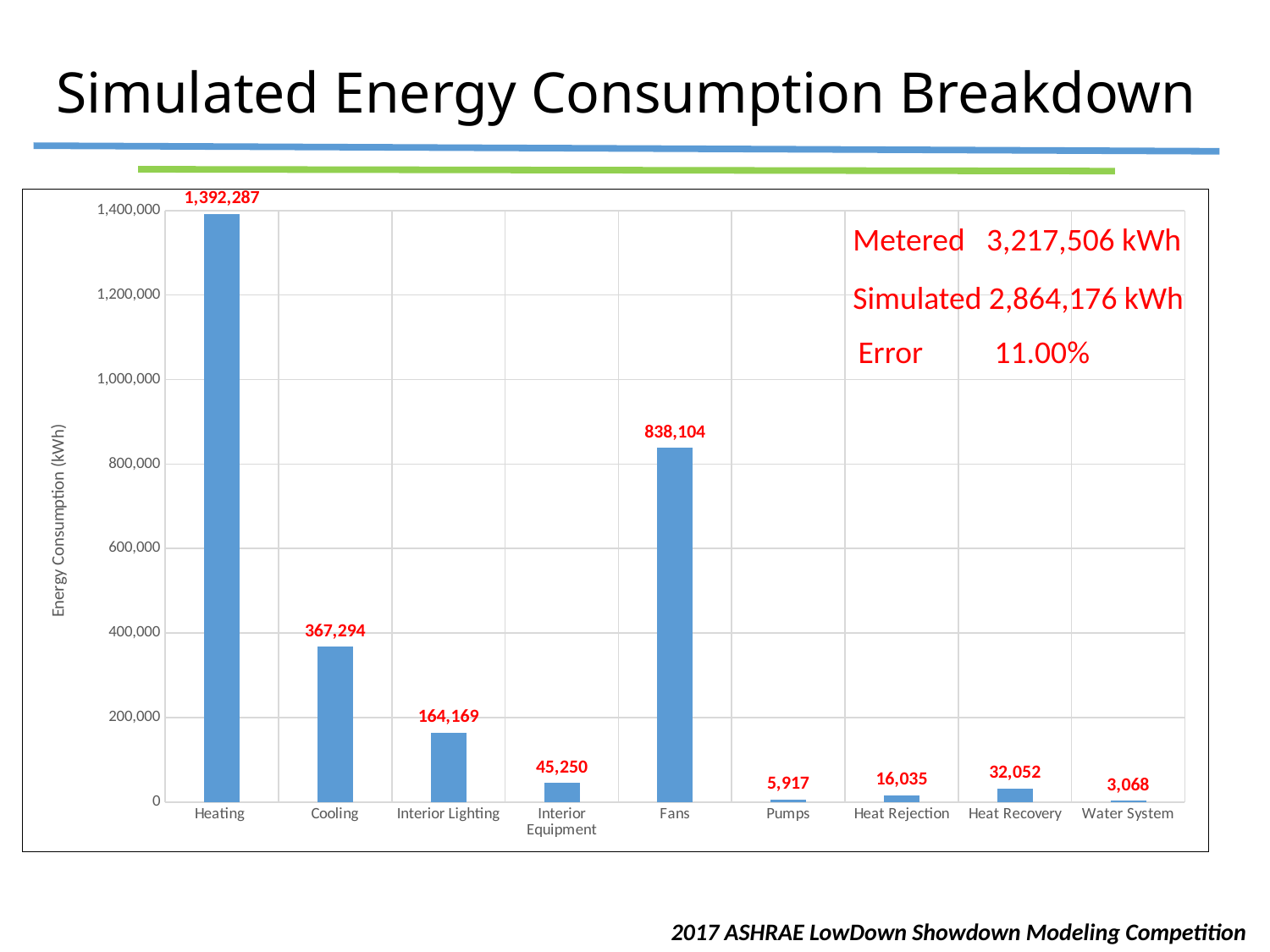
Is the value for Fans greater or less than 800,000? greater What is the energy consumption value for Heating? 1,392,287 Which category has the lowest energy consumption? Water System How many categories are shown on the x axis? 9 Which category has the highest energy consumption? Heating What is the energy consumption value for Heat Recovery? 32,052 What is the difference in energy consumption between Cooling and Interior Lighting? 203,125 What is the energy consumption value for Fans? 838,104 Which has a higher energy consumption, Heat Rejection or Heat Recovery? Heat Recovery What is the label of the y axis? Energy Consumption (kWh) What kind of chart is shown on the slide? Bar chart What is the difference in energy consumption between Heating and Fans? 554,183